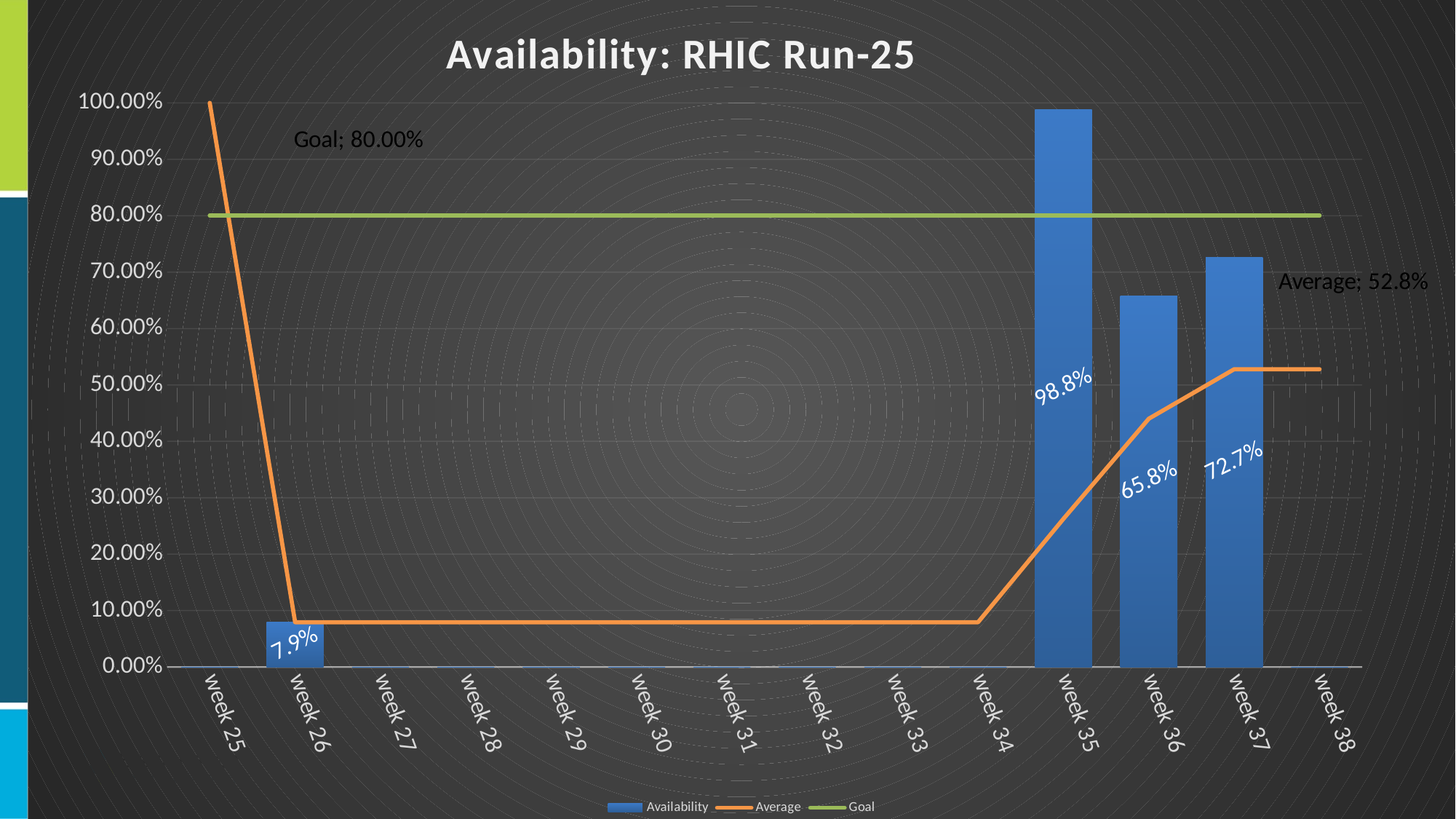
What is the difference between the Availability for week 35 and week 37? 26.1% What is the Availability value for week 35? 98.8% How many series does the legend list? 3 What value is labelled for the Goal line? 80.00% Which week has the highest Availability bar? week 35 What value is labelled for the Average at the end of the series? 52.8% How many week categories are shown on the x axis? 14 What is the Availability value for week 36? 65.8% What is the title of the chart? Availability: RHIC Run-25 What is the Availability value for week 37? 72.7% Which is larger, the Availability for week 36 or week 37? week 37 What is the Availability value for week 26? 7.9%